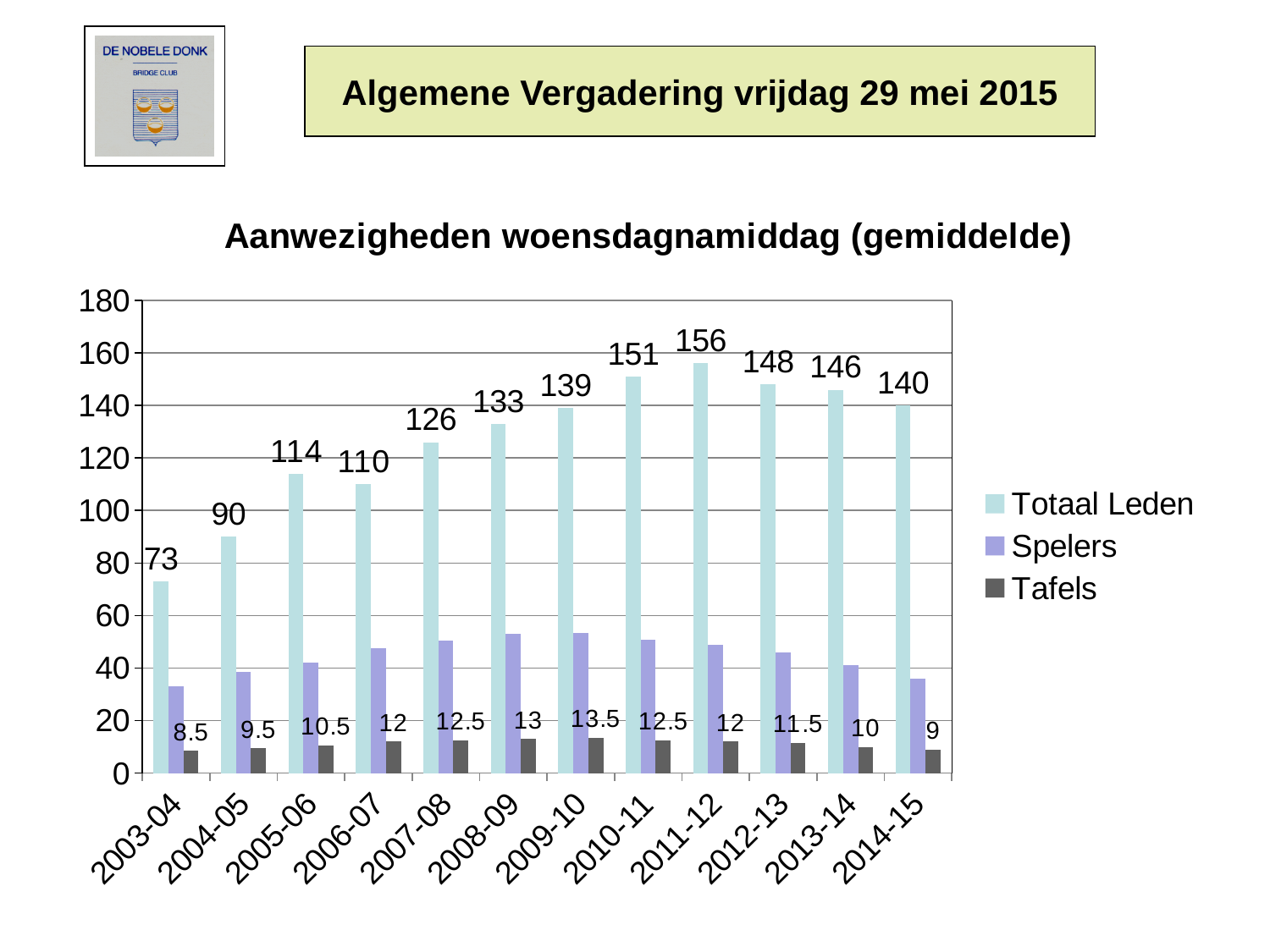
What is the title of the chart? Aanwezigheden woensdagnamiddag (gemiddelde) How many series does the legend list? 3 How many seasons are shown on the x axis? 12 Which season has the highest Totaal Leden value? 2011-12 What kind of chart is shown on the slide? bar chart Which is larger, the Totaal Leden value for 2005-06 or for 2006-07? 2005-06 Is the Spelers value for 2003-04 greater or less than 40? less What is the Totaal Leden value for 2011-12? 156 What is the Tafels value for 2009-10? 13.5 What is the difference between the Totaal Leden values for 2011-12 and 2003-04? 83 Do the Totaal Leden values rise or fall from 2011-12 to 2014-15? fall Which season has the lowest Tafels value? 2003-04